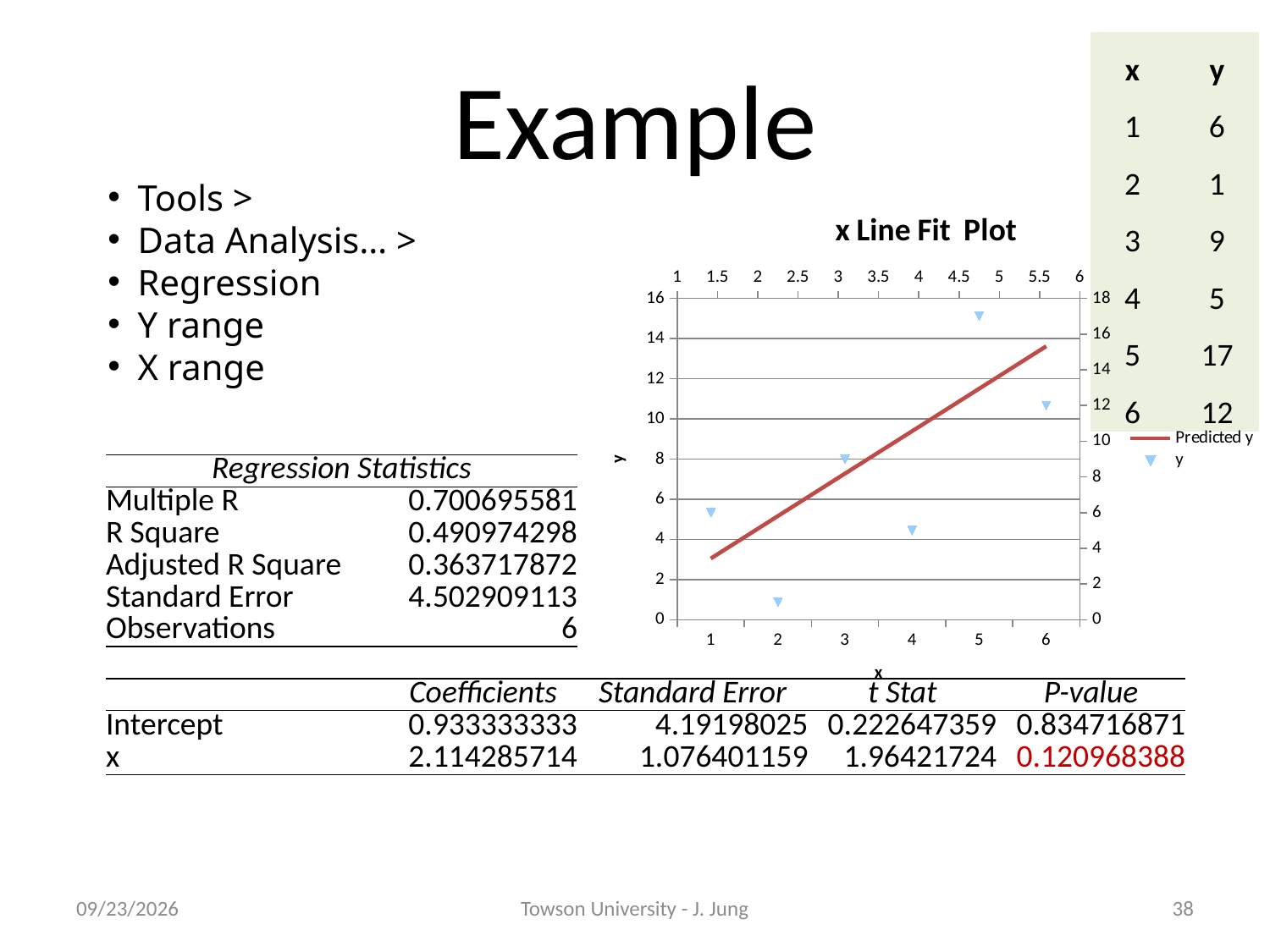
In the x Line Fit Plot, which has the larger y value, x = 4 or x = 5? x = 5 In the x Line Fit Plot, which has the larger y value, x = 2 or x = 3? x = 3 In the x Line Fit Plot, is the y value at x = 2 greater or less than 4? less In the x Line Fit Plot, is the y value at x = 5 greater or less than 12? greater How many series does the legend of the x Line Fit Plot list? 2 In the x Line Fit Plot, at which x value is the plotted y point highest? 5 What kind of chart is the x Line Fit Plot? scatter plot with a fitted line What are the two series named in the legend of the x Line Fit Plot? Predicted y and y How many data points are plotted for the y series in the x Line Fit Plot? 6 Does the Predicted y line in the x Line Fit Plot rise or fall as x increases? rise What is the title of the chart on the slide? x Line Fit Plot In the x Line Fit Plot, at which x value is the plotted y point lowest? 2